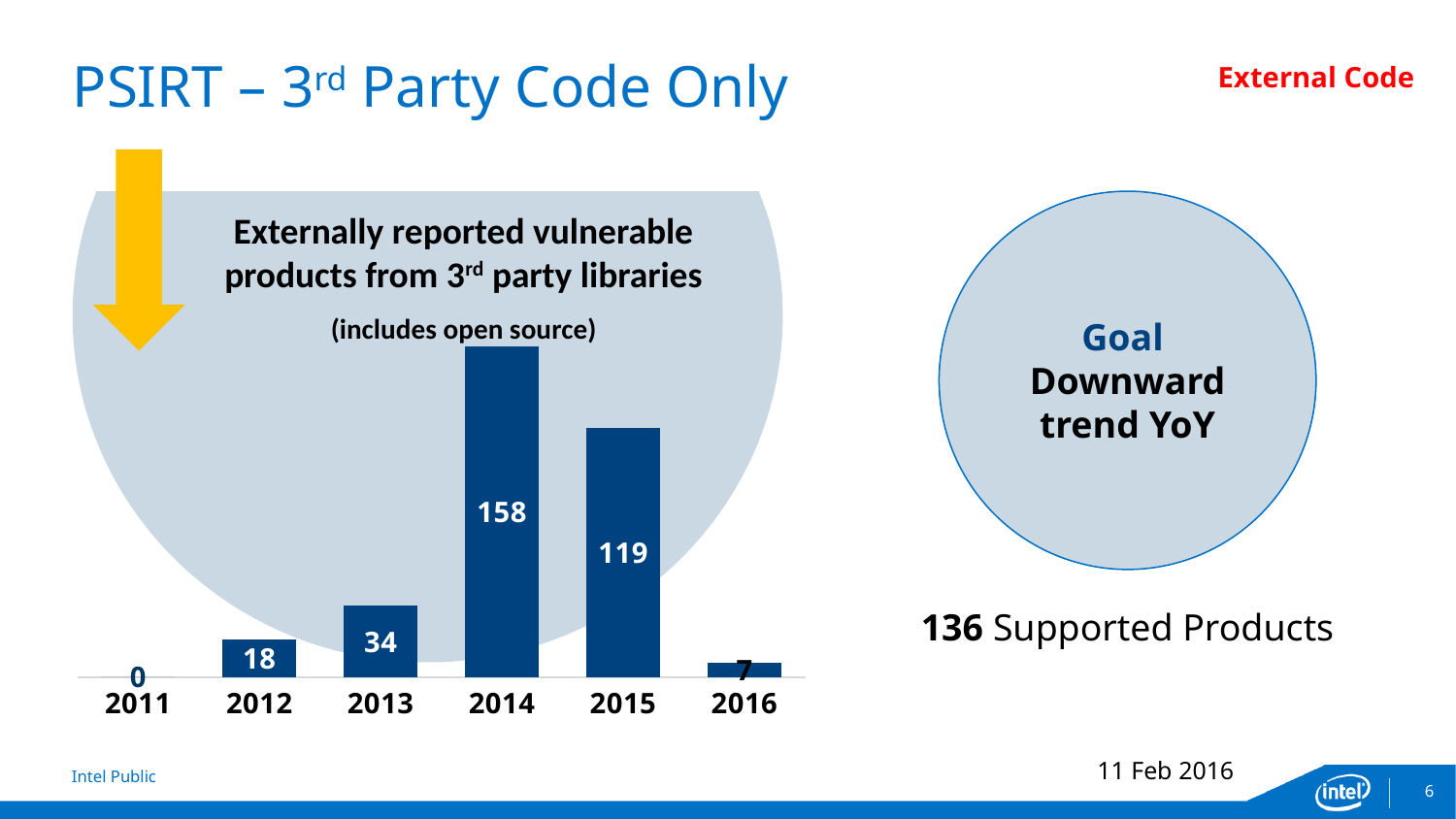
Which year has the highest value? 2014 What is the value for 2015? 119 What is the difference between the values for 2014 and 2015? 39 What kind of chart is shown? bar chart How many years are shown on the x axis? 6 Which is larger, the value for 2013 or the value for 2012? 2013 What is the title of the chart? Externally reported vulnerable products from 3rd party libraries (includes open source) Which year has the lowest value? 2011 What is the value for 2016? 7 Do the values rise or fall from 2014 to 2016? fall What is the value for 2012? 18 What is the value for 2014? 158